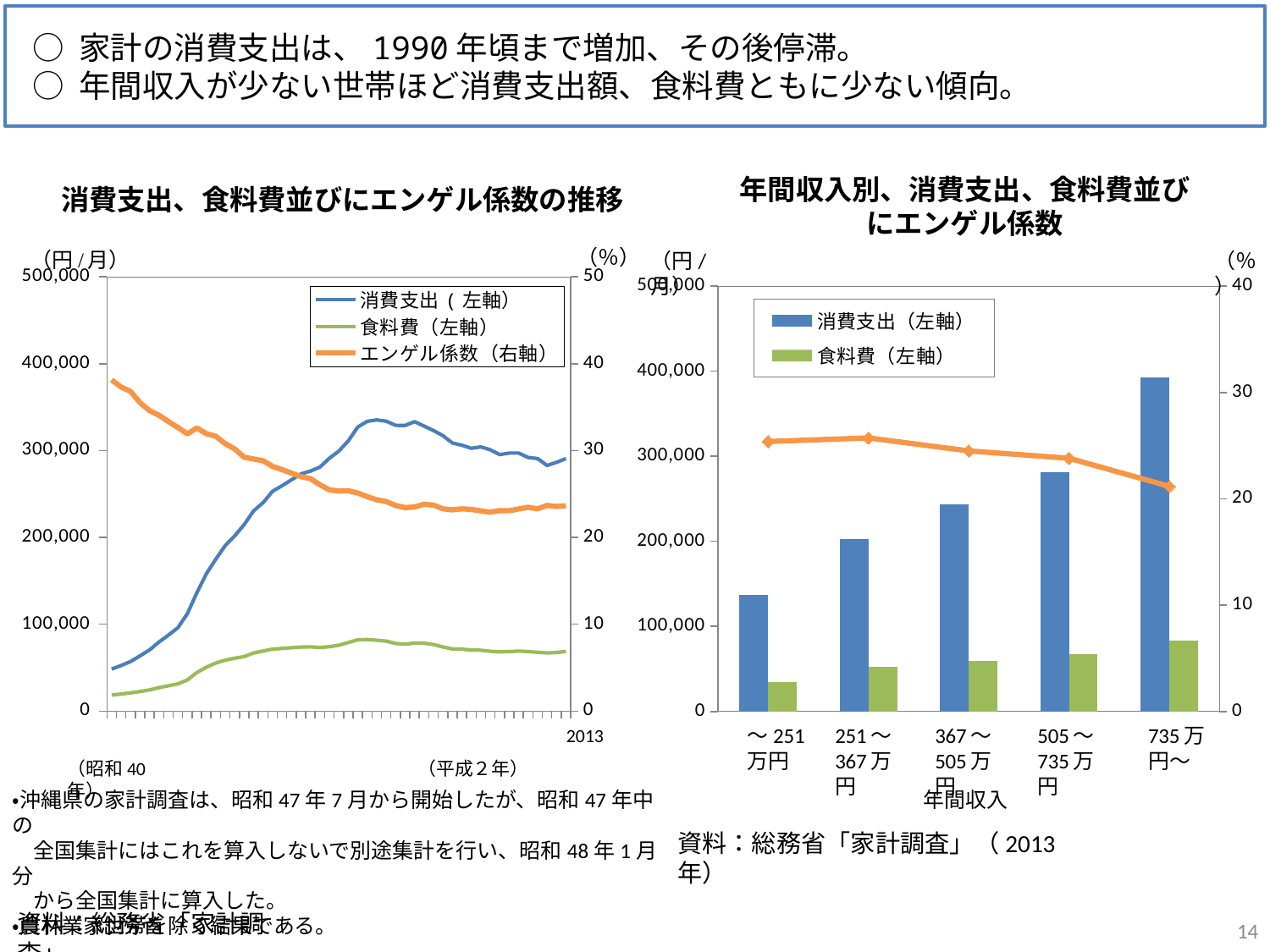
In the right chart (年間収入別、消費支出、食料費並びにエンゲル係数), which income category has the highest 消費支出? 735万円～ In the right chart (年間収入別、消費支出、食料費並びにエンゲル係数), which is larger: the 消費支出 for 251～367万円 or for 505～735万円? 505～735万円 How many series does the legend of the right chart (年間収入別、消費支出、食料費並びにエンゲル係数) list? 2 In the left chart (消費支出、食料費並びにエンゲル係数の推移), which series is plotted on the right axis? エンゲル係数 In the left chart (消費支出、食料費並びにエンゲル係数の推移), does the エンゲル係数 line rise or fall over time? fall How many series does the legend of the left chart (消費支出、食料費並びにエンゲル係数の推移) list? 3 In the right chart (年間収入別、消費支出、食料費並びにエンゲル係数), which income category has the lowest 食料費? ～251万円 In the right chart (年間収入別、消費支出、食料費並びにエンゲル係数), is the 消費支出 value for ～251万円 greater or less than 200,000? less What kind of chart is the left chart titled 消費支出、食料費並びにエンゲル係数の推移? line chart In the right chart (年間収入別、消費支出、食料費並びにエンゲル係数), how many income categories are shown on the x axis? 5 In the right chart (年間収入別、消費支出、食料費並びにエンゲル係数), do the 消費支出 bars rise or fall as annual income increases along the x axis? rise In the right chart (年間収入別、消費支出、食料費並びにエンゲル係数), is the 消費支出 value for 735万円～ greater or less than 300,000? greater